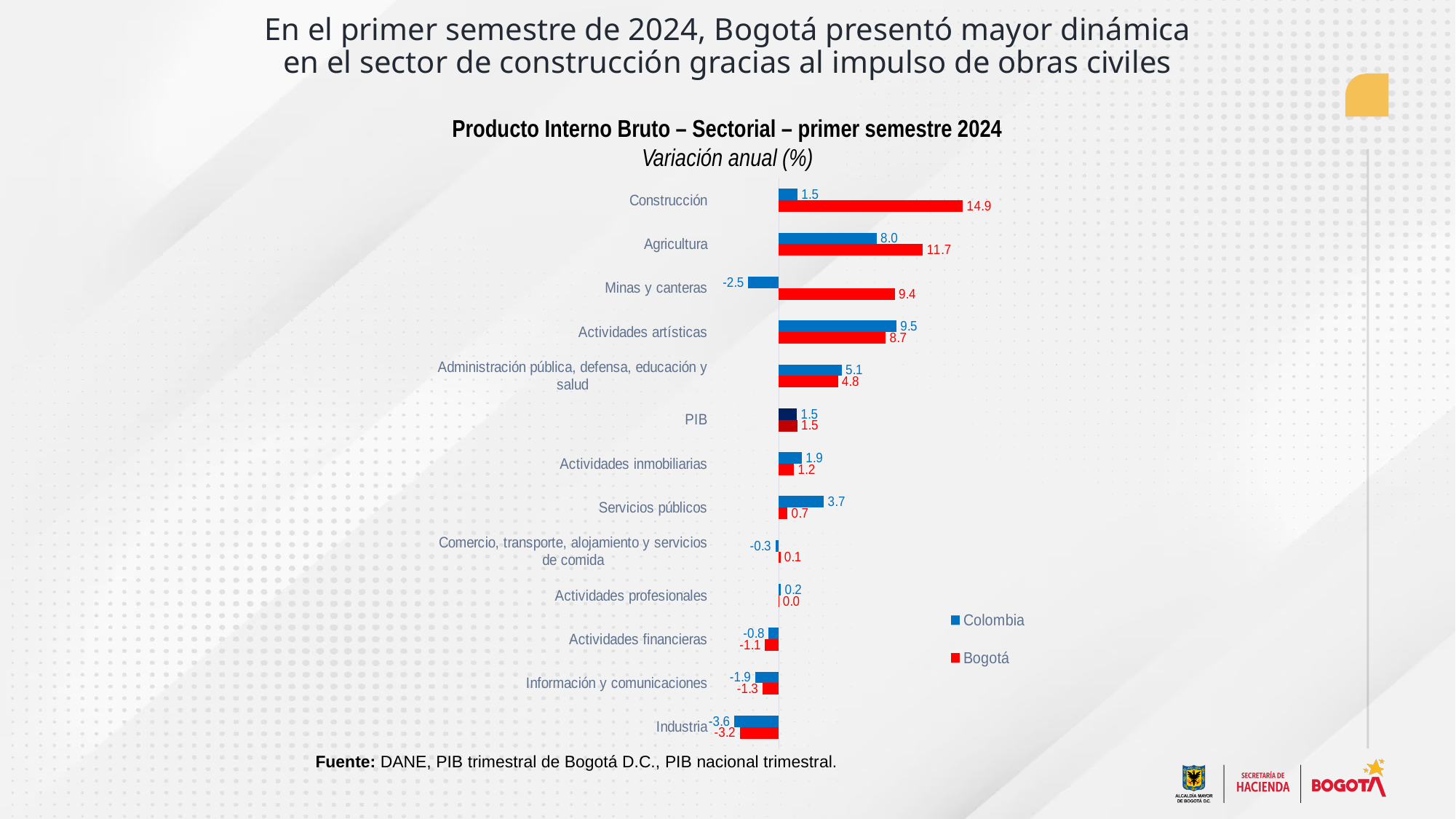
What kind of chart is shown on the slide? Bar chart How many series does the legend list? 2 What is the Bogotá value for Agricultura? 11.7 What is the Colombia value for Servicios públicos? 3.7 Which category has the highest Bogotá value? Construcción What is the difference between the Bogotá and Colombia values for Construcción? 13.4 What is the Bogotá value for Construcción? 14.9 What is the Colombia value for Minas y canteras? -2.5 Which colour represents Bogotá in the chart? Red Which is larger for Actividades artísticas, the Colombia value or the Bogotá value? Colombia Which category has the lowest Colombia value? Industria How many categories are shown on the chart? 13